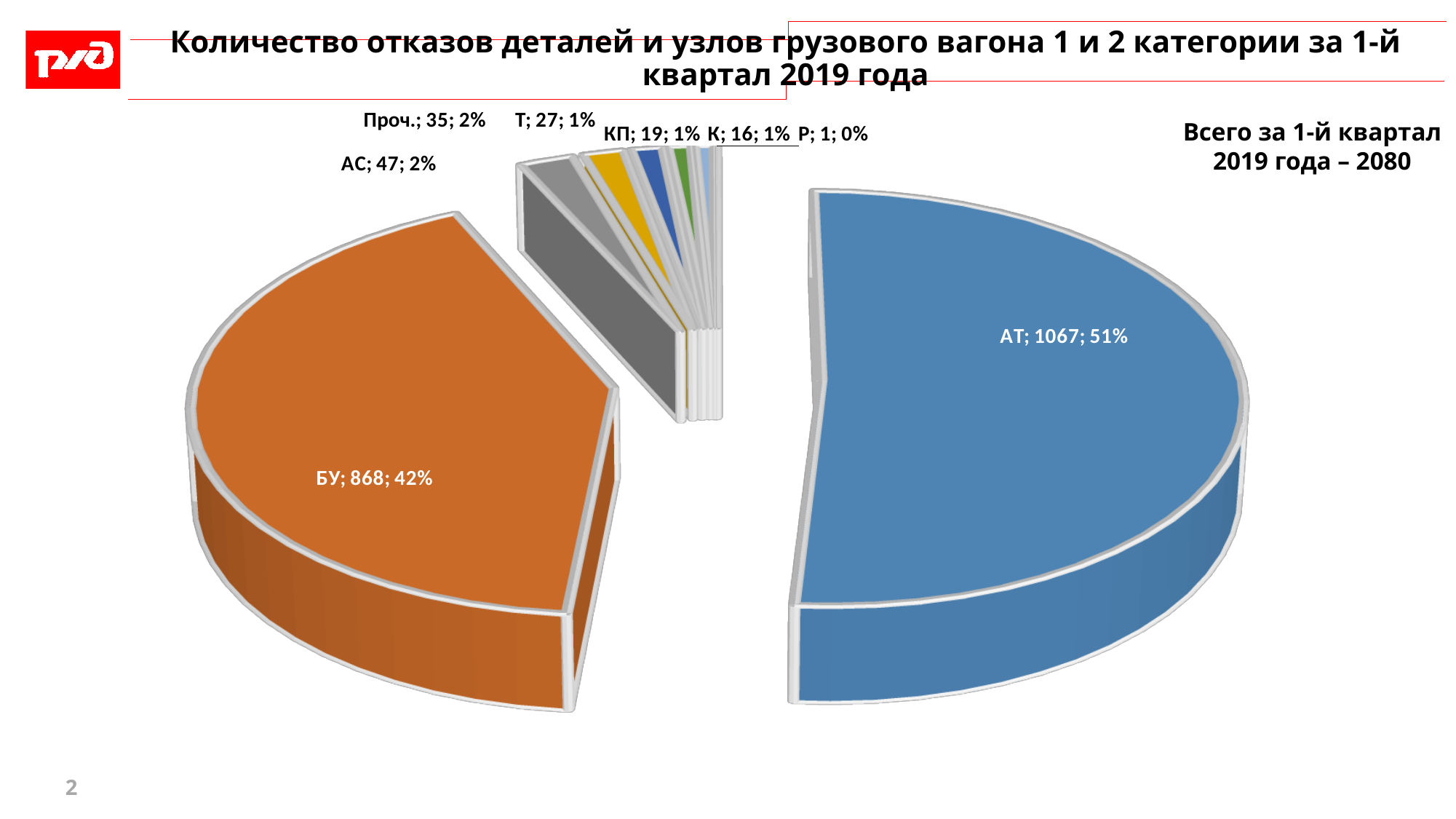
Which category has the lowest number of failures? Р What kind of chart is shown on the slide? pie chart What total for the 1st quarter of 2019 is stated on the slide? 2080 How many categories (slices) does the pie chart have? 8 How many failures are shown for the АС category? 47 What is the difference between the АТ and БУ values? 199 Which is larger, the value for Т or the value for КП? Т What share of the pie does the АТ slice represent? 51% How many failures are shown for the АТ category? 1067 What share of the pie does the БУ slice represent? 42% Which category has the highest number of failures? АТ What colour is the БУ slice? orange